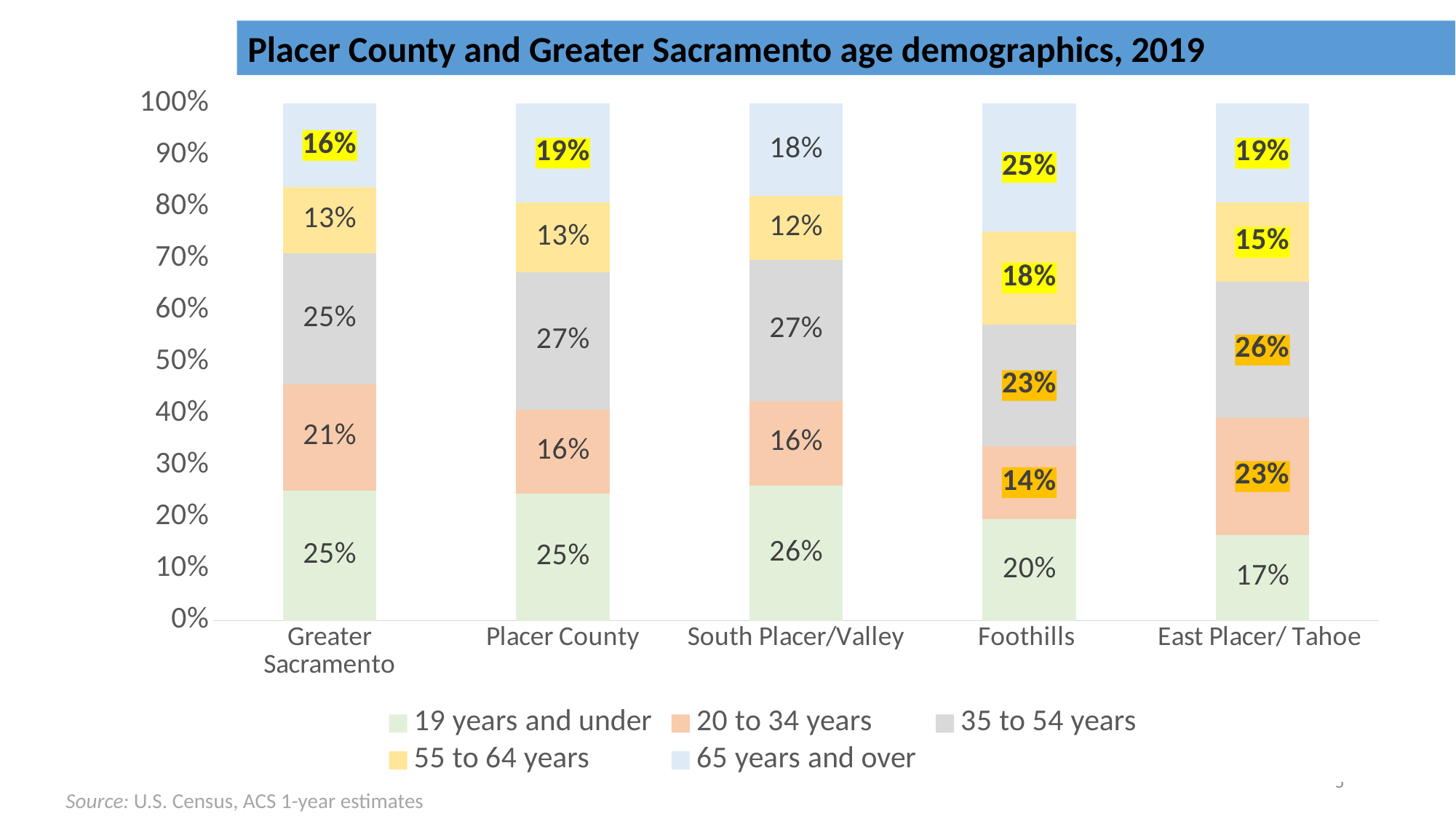
Which region has the lowest share of residents 19 years and under? East Placer/ Tahoe What share of the South Placer/Valley population is 55 to 64 years? 12% What is the difference between the 65 years and over share in Foothills and in Greater Sacramento? 9 percentage points What type of chart is shown? Stacked bar chart What share of the Foothills population is 65 years and over? 25% What share of the East Placer/ Tahoe population is 35 to 54 years? 26% Which is larger: the 20 to 34 years share in East Placer/ Tahoe or in Placer County? East Placer/ Tahoe What share of the Greater Sacramento population is 20 to 34 years? 21% Which region has the highest share of residents 65 years and over? Foothills How many age groups does the legend list? 5 What is the title of the chart? Placer County and Greater Sacramento age demographics, 2019 How many regions are shown on the x axis? 5